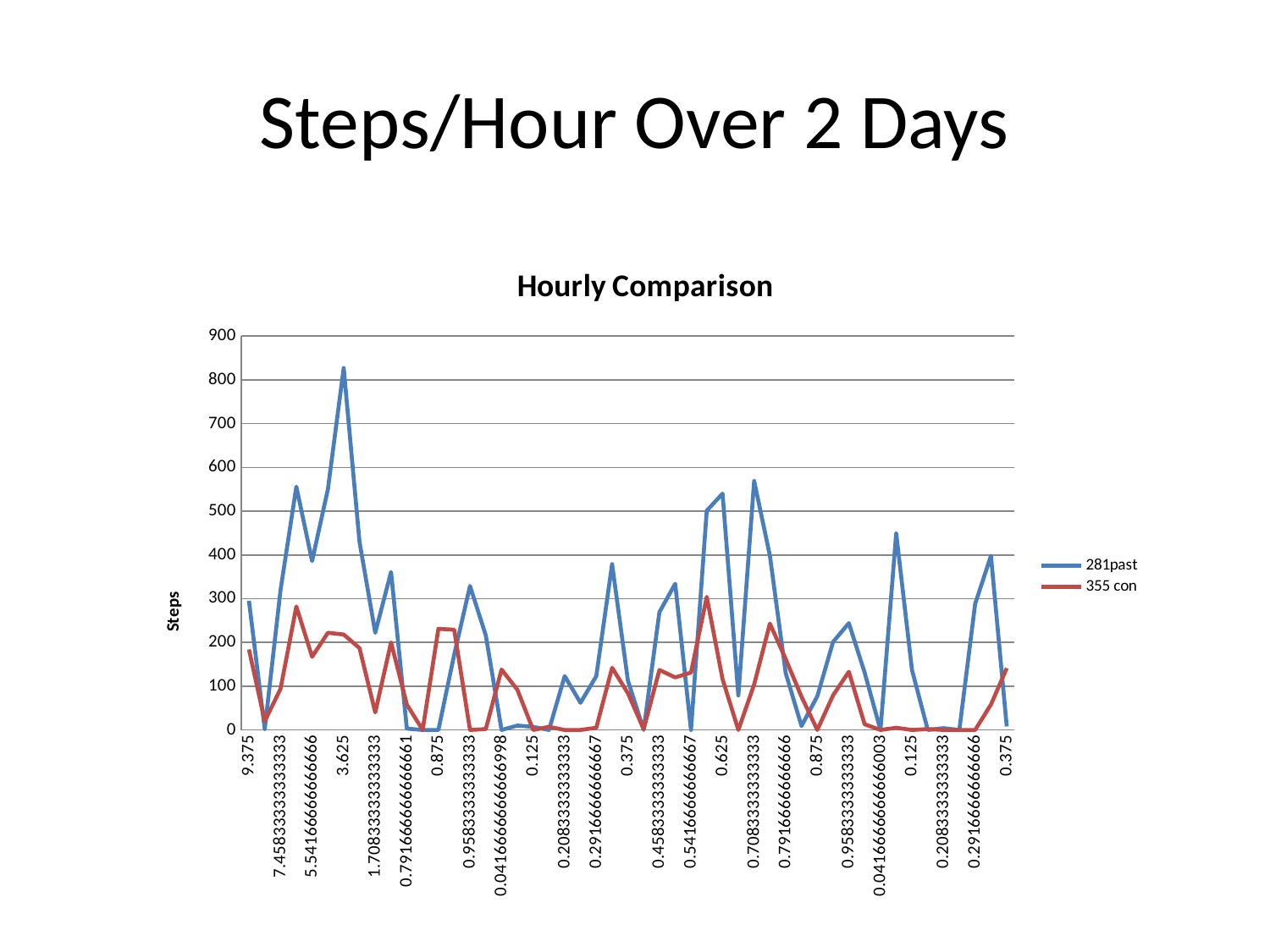
Is the highest point of the 355 con line greater or less than 200? greater What is the title of the chart? Hourly Comparison Is the highest point of the 281past line greater or less than 800? greater Is the value of the 355 con line at the first x-axis point (9.375) greater or less than 100? greater Which series has the lower peak value? 355 con What kind of chart is shown on the slide? line chart How many series does the legend list? 2 What is the maximum value shown on the vertical axis? 900 Which series reaches the higher peak value, 281past or 355 con? 281past What are the two series named in the legend? 281past and 355 con